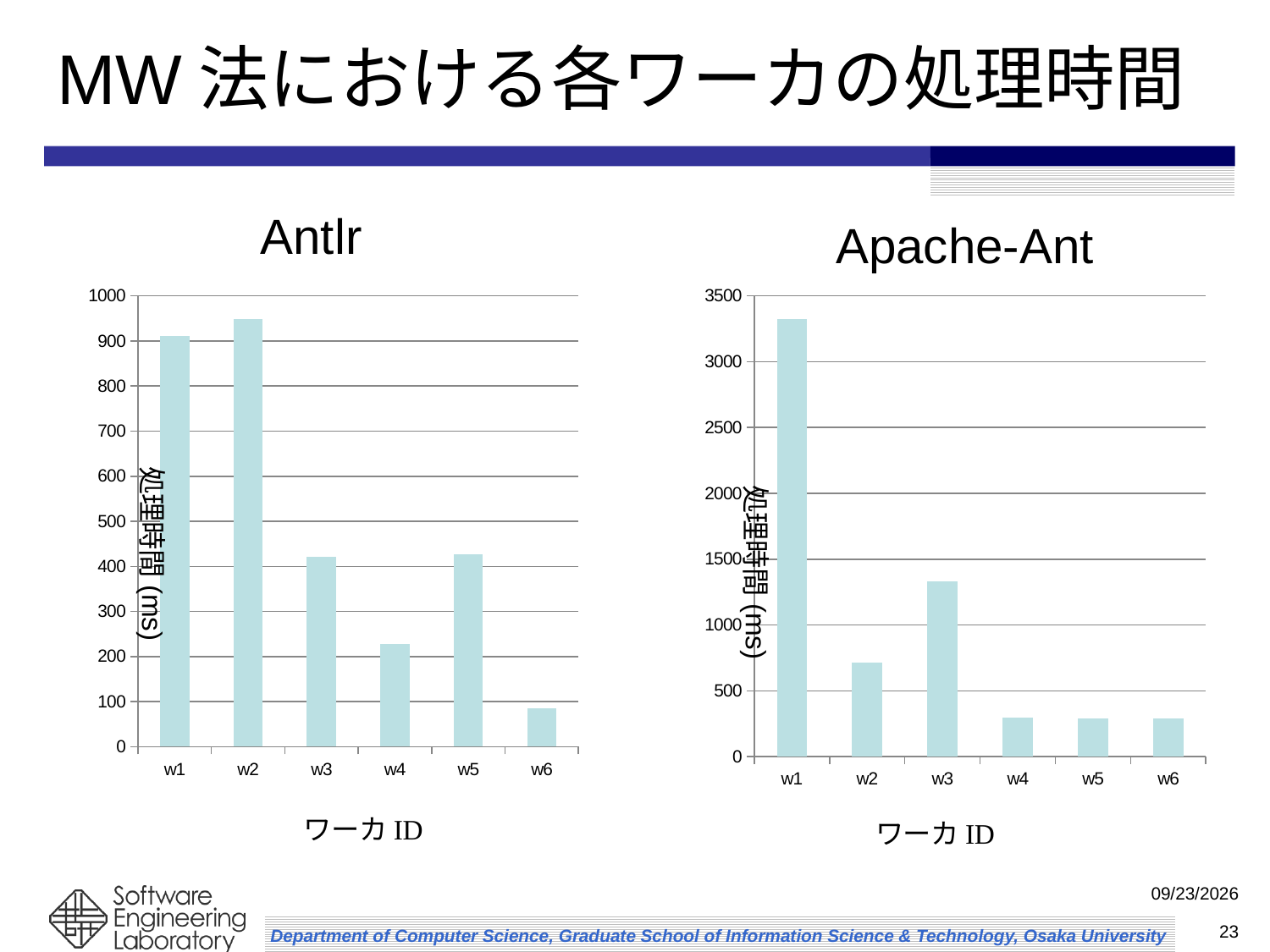
In the Apache-Ant chart, is the value for w1 greater or less than 3000? greater In the Apache-Ant chart, is the value for w2 greater or less than 1000? less In the Antlr chart, which worker has the highest processing time? w2 In the Antlr chart, is the value for w1 greater or less than 900? greater How many workers are shown on the x axis of the Antlr chart? 6 In the Antlr chart, which has the larger value, w1 or w4? w1 In the Apache-Ant chart, which has the larger value, w2 or w3? w3 In the Antlr chart, which worker has the lowest processing time? w6 In the Apache-Ant chart, which worker has the highest processing time? w1 What kind of chart is the Apache-Ant chart? bar chart